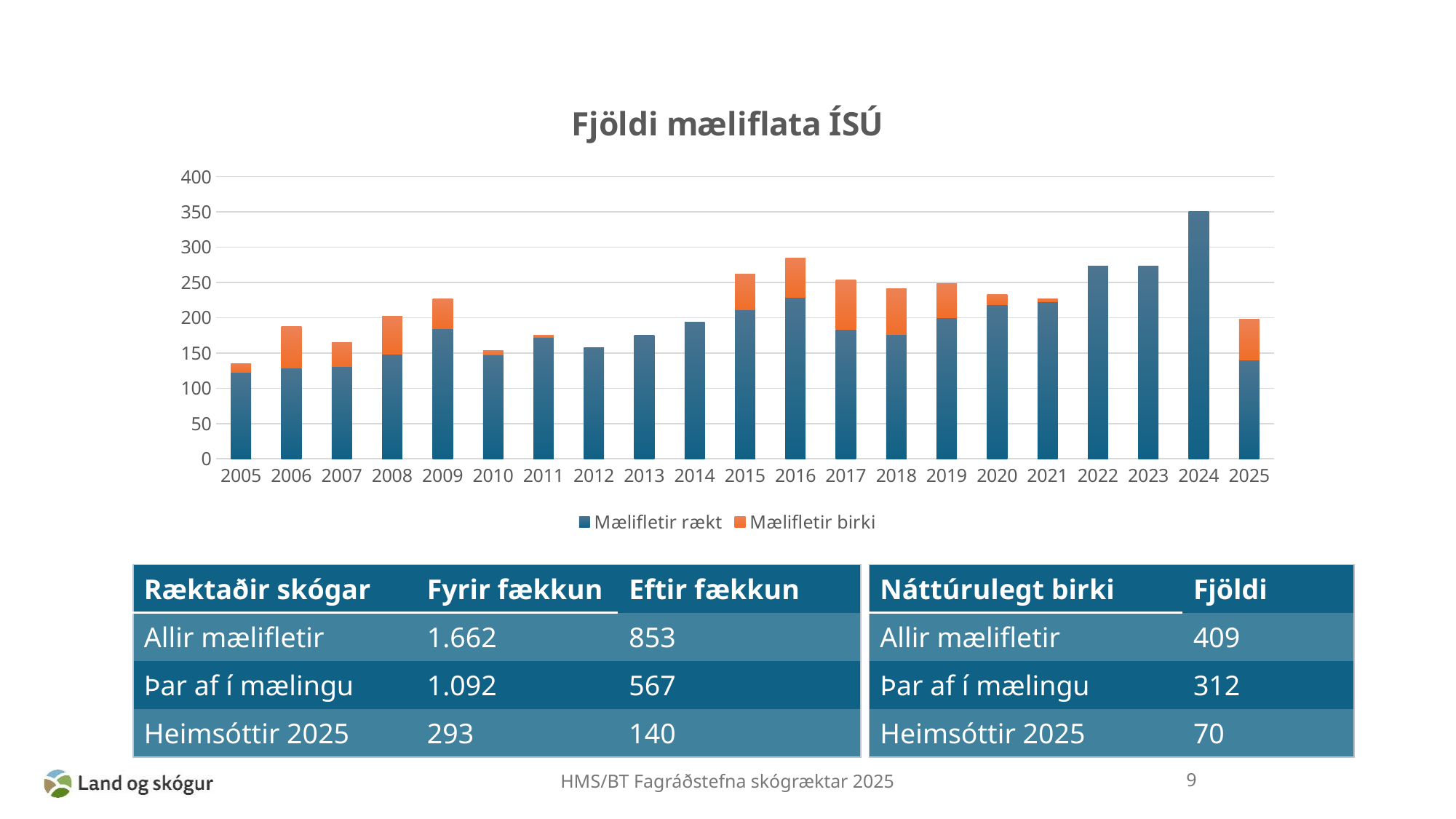
Is the total value for 2016 greater or less than 250? greater Is the Mælifletir rækt value for 2025 greater or less than 150? less How many series does the chart legend list? 2 How many years are shown on the x axis of the chart? 21 Which series is shown in orange in the chart? Mælifletir birki Is the total value for 2024 greater or less than 300? greater What is the title of the chart? Fjöldi mæliflata ÍSÚ Which year has a larger total bar, 2023 or 2024? 2024 Which year has the highest total bar in the chart? 2024 Which year has the lowest total bar in the chart? 2005 What kind of chart is shown on the slide? stacked bar chart